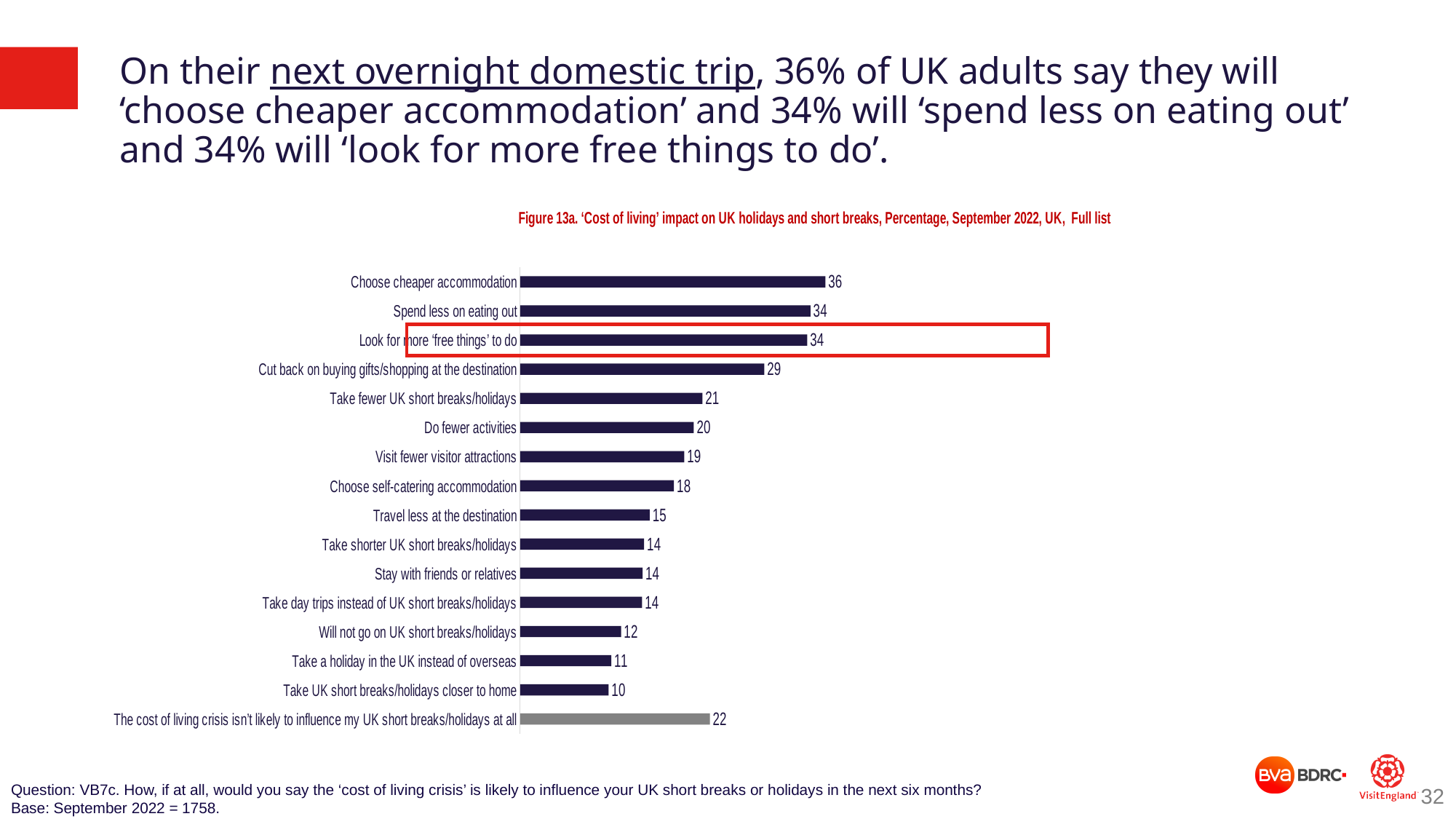
How many categories are shown in the chart? 16 What value is shown for 'The cost of living crisis isn't likely to influence my UK short breaks/holidays at all'? 22 Which bar is shown in a different colour (grey) from the others? The cost of living crisis isn't likely to influence my UK short breaks/holidays at all What is the difference between the values for 'Choose cheaper accommodation' and 'Spend less on eating out'? 2 Which category has the highest value? Choose cheaper accommodation What type of chart is shown on the slide? Bar chart What is the difference between the values for 'Take fewer UK short breaks/holidays' and 'Will not go on UK short breaks/holidays'? 9 Which category has the lowest value? Take UK short breaks/holidays closer to home What value is shown for 'Choose self-catering accommodation'? 18 Which is larger: the value for 'Do fewer activities' or the value for 'Travel less at the destination'? Do fewer activities What value is shown for 'Choose cheaper accommodation'? 36 What value is shown for 'Cut back on buying gifts/shopping at the destination'? 29